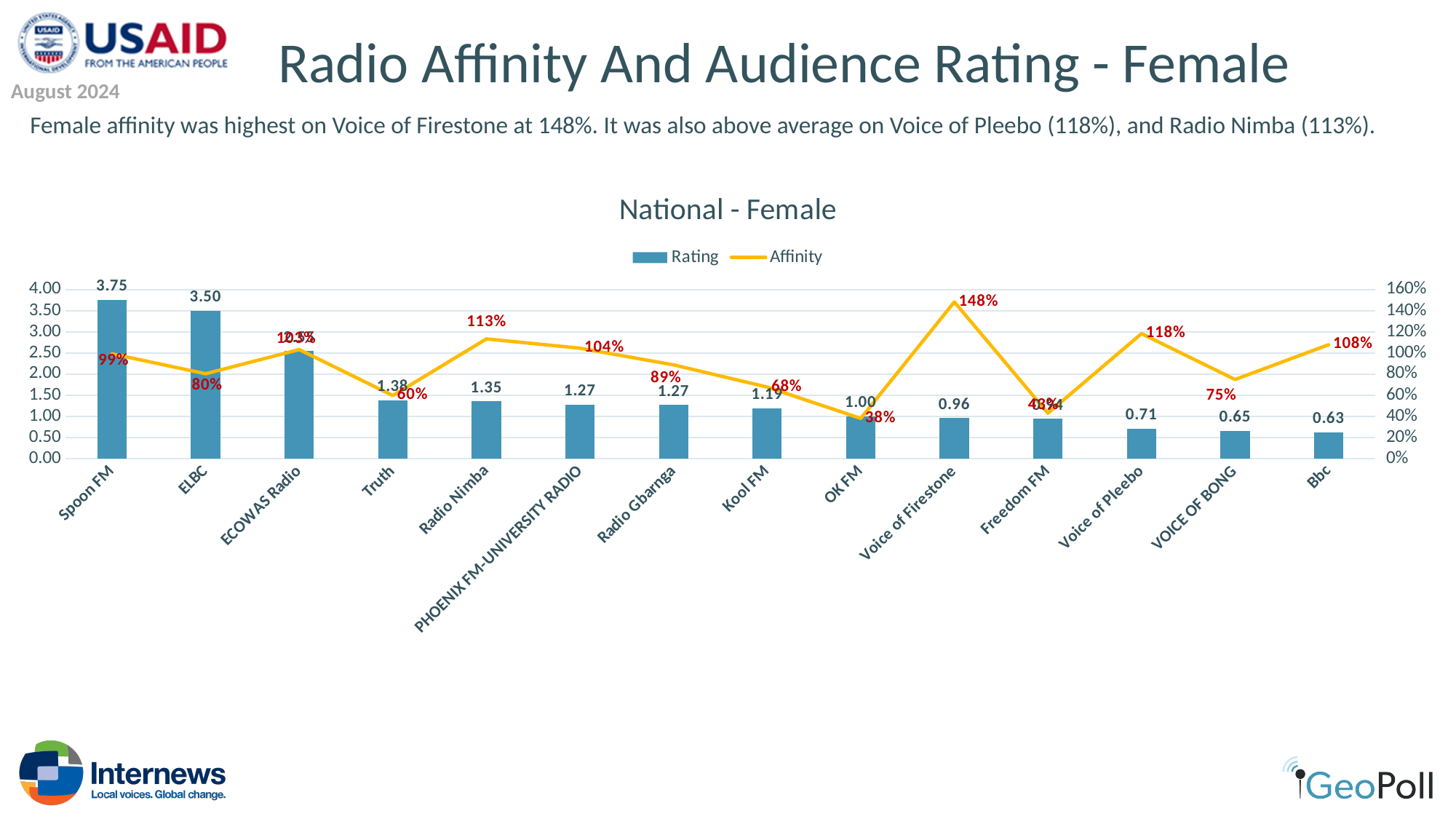
Which station has the lowest Rating? Bbc Which station has the highest Affinity? Voice of Firestone How many radio stations are shown on the x axis? 14 Which station has the lowest Affinity? OK FM How many series does the legend list? 2 Which has the higher Affinity, Radio Nimba or Voice of Pleebo? Voice of Pleebo What is the Rating value for Spoon FM? 3.75 What is the Rating value for Kool FM? 1.19 What is the Affinity value for Voice of Firestone? 148% What kind of chart is shown on the slide? A combined bar and line chart What is the Affinity value for Truth? 60% What is the difference between the Rating for Spoon FM and the Rating for ELBC? 0.25